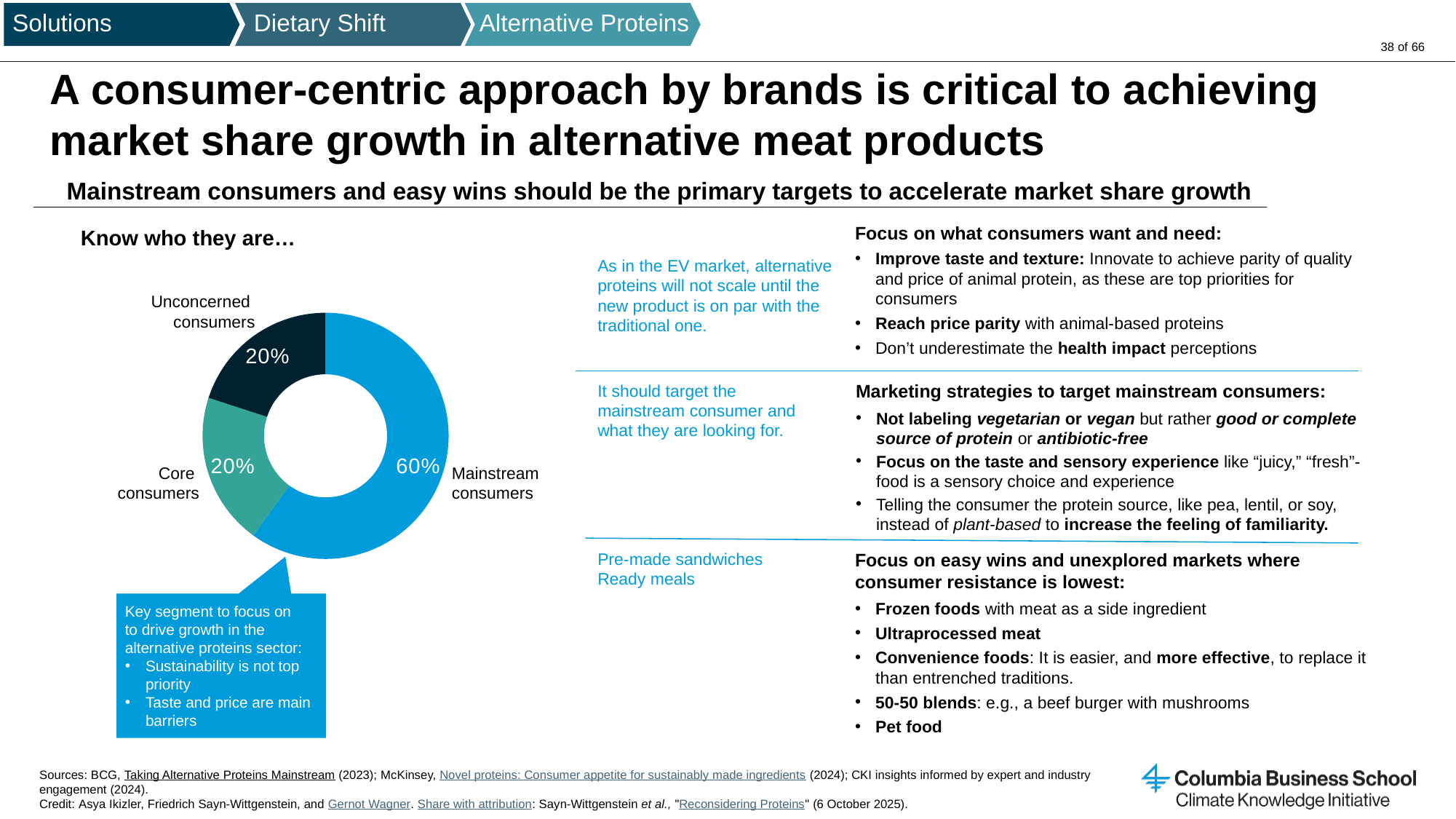
Which consumer segment has the largest share in the donut chart? Mainstream consumers What is the heading above the donut chart? Know who they are… Do the Core consumers and Unconcerned consumers segments have the same share? Yes, both 20% What is the combined share of the Core consumers and Unconcerned consumers segments? 40% Which segment is larger in the donut chart, Mainstream consumers or Unconcerned consumers? Mainstream consumers What is the difference in percentage points between the Mainstream consumers and Core consumers segments? 40 percentage points What share of the donut chart is labeled Mainstream consumers? 60% What percentage is shown for Unconcerned consumers in the donut chart? 20% What percentage is shown for Core consumers in the donut chart? 20% How many segments does the donut chart have? 3 Which segment of the donut chart does the callout box identify as the key segment to focus on? Mainstream consumers What type of chart is shown on the slide? Donut (pie) chart